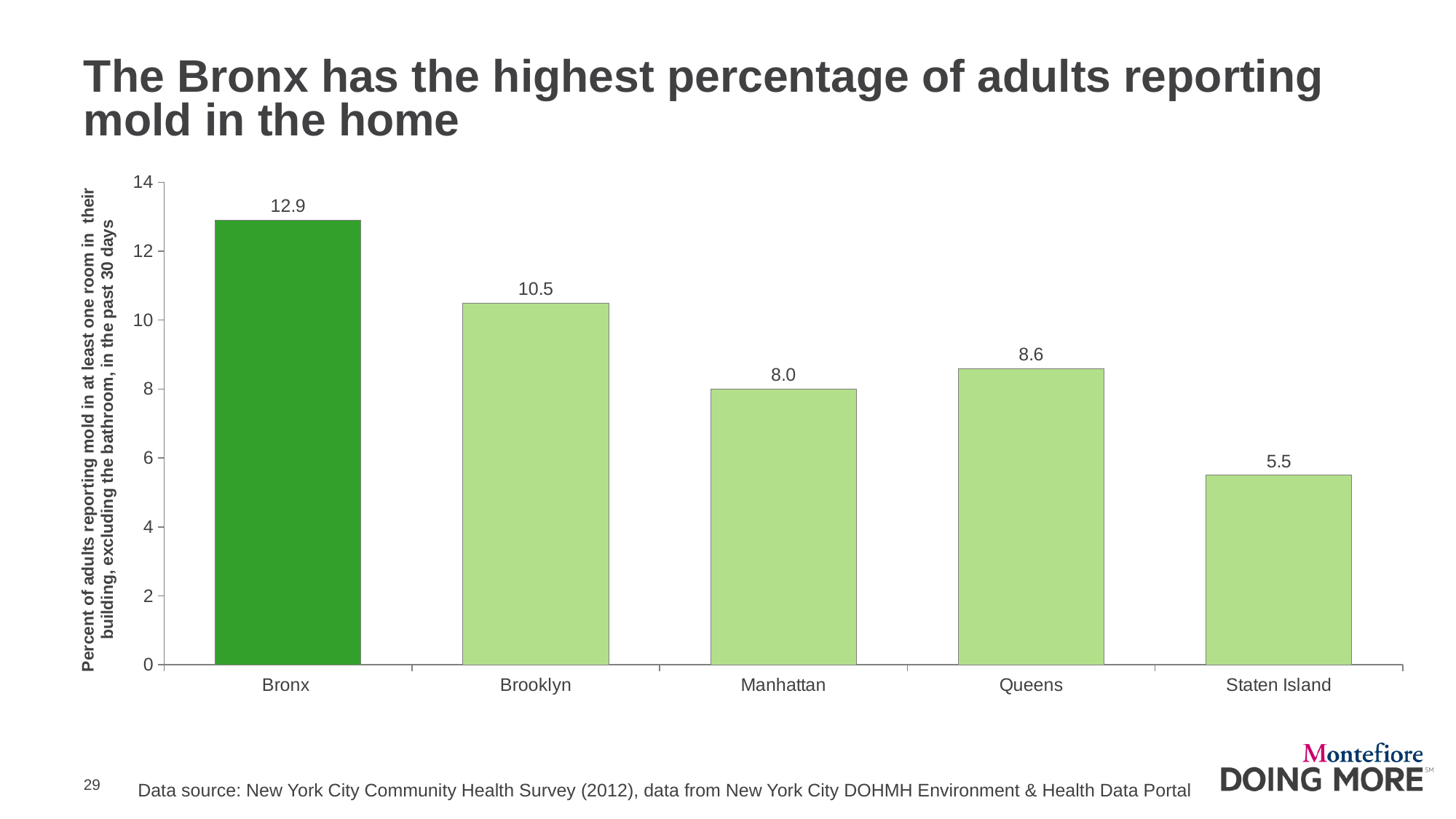
Which has a larger value, Manhattan or Queens? Queens What is the value for Staten Island? 5.5 Which borough has the lowest value? Staten Island What is the value for Manhattan? 8.0 What is the value for Brooklyn? 10.5 What kind of chart is shown on the slide? Bar chart What is the value for Bronx? 12.9 What is the difference between the values for Queens and Staten Island? 3.1 Which bar is shown in a darker green than the others? Bronx What is the difference between the values for Bronx and Brooklyn? 2.4 Which borough has the highest value? Bronx How many boroughs are shown on the chart? 5